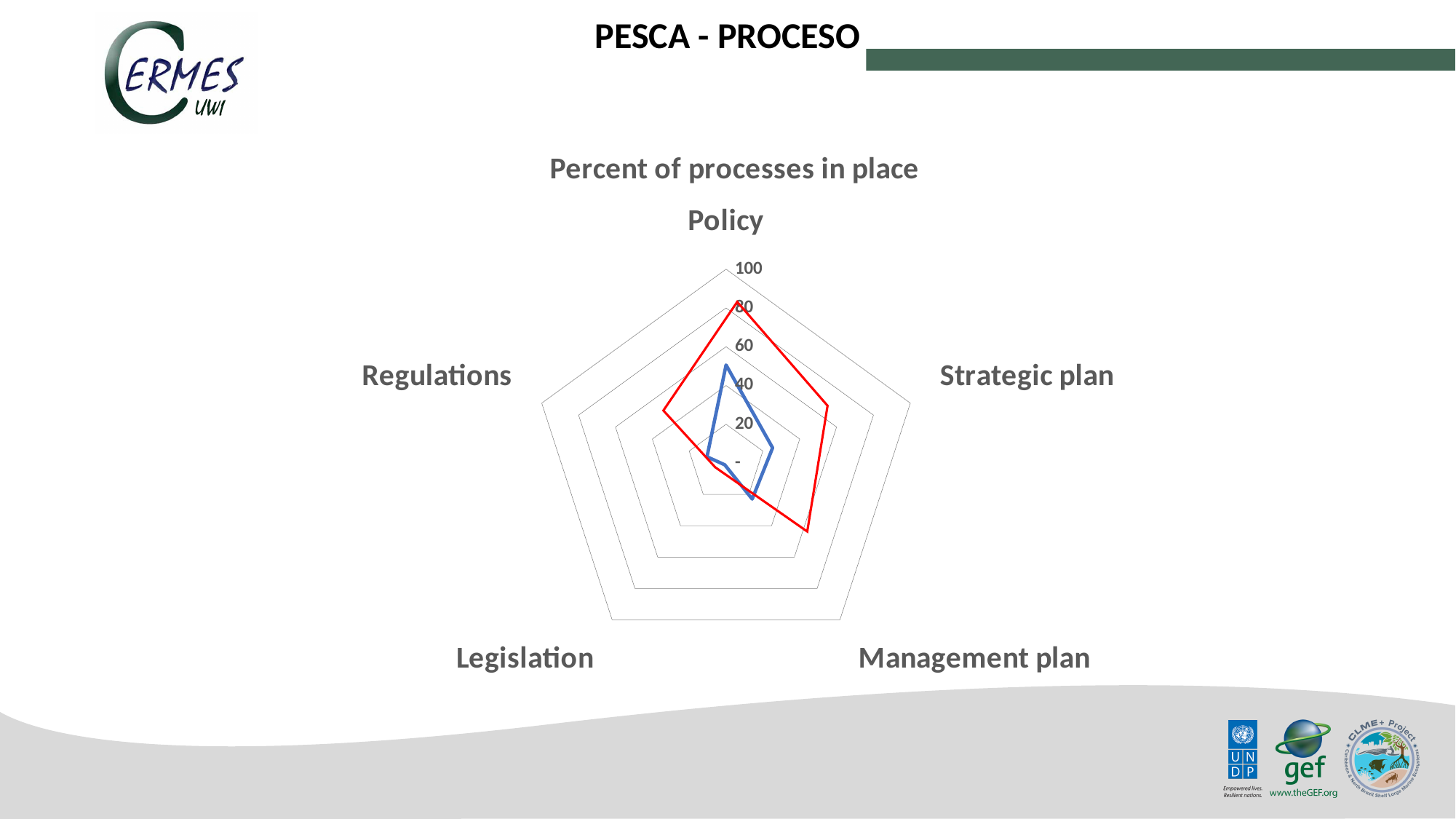
What is the title of the chart? Percent of processes in place What kind of chart is shown on the slide? Radar chart Is the red series value for Policy greater or less than 60? greater For Policy, which series has the larger value, the red or the blue? Red Is the blue series value for Policy greater or less than 60? less Is the red series value for Legislation greater or less than 40? less How many categories (axes) does the radar chart have? 5 Which category has the lowest value for the red series? Legislation What is the highest value shown on the chart's axis scale? 100